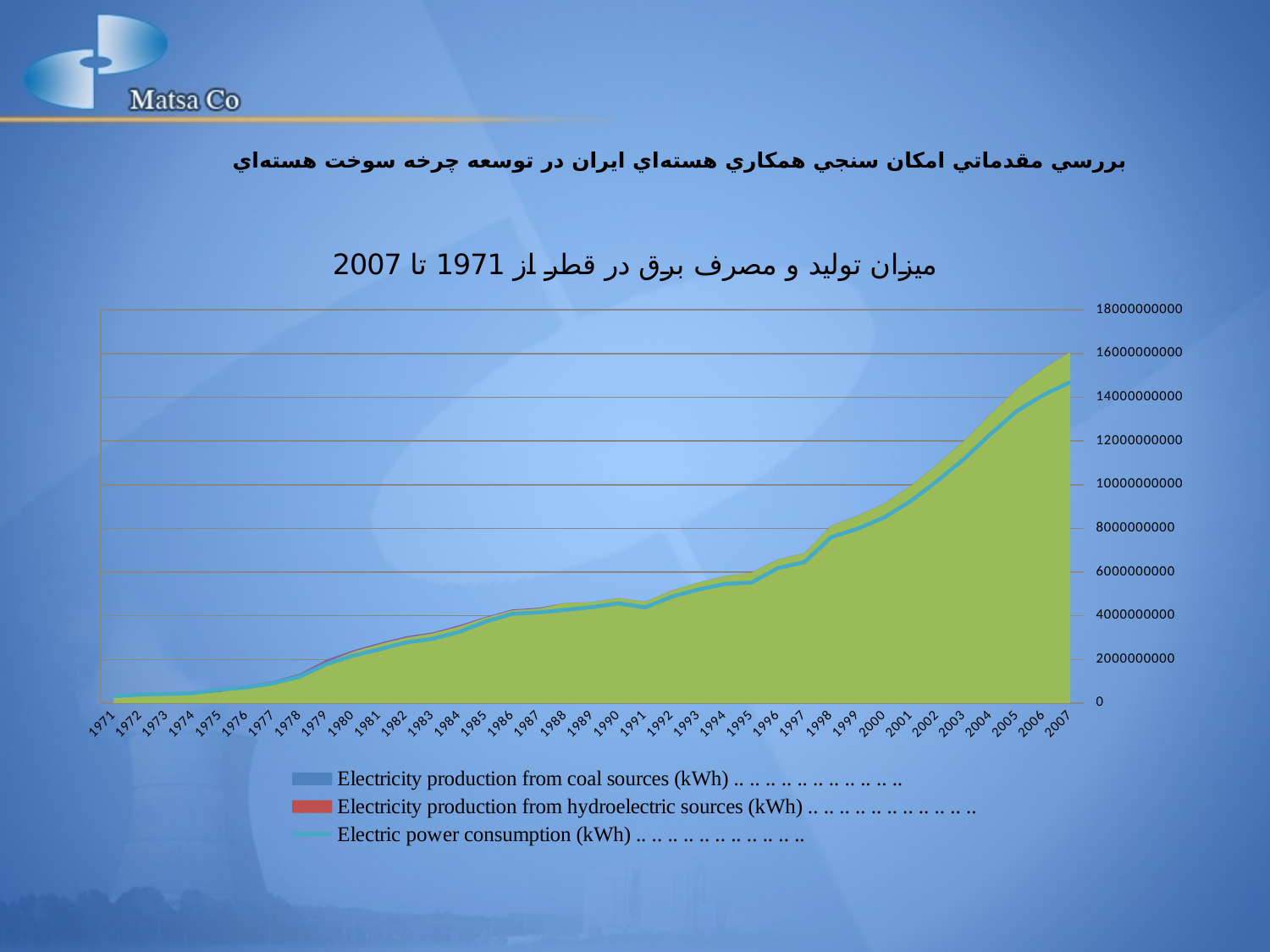
Which year has the larger value for Electric power consumption (kWh), 1995 or 2005? 2005 How many years are plotted along the x axis of the chart? 37 How many series does the chart legend list? 3 What is the first year shown on the x axis of the chart? 1971 What is the last year shown on the x axis of the chart? 2007 In which year is Electric power consumption (kWh) lowest? 1971 What kind of chart is shown on the slide? area and line chart Is the value for Electric power consumption (kWh) in 2007 greater or less than 10000000000? greater Is the value for Electric power consumption (kWh) in 1980 greater or less than 4000000000? less In which year is Electric power consumption (kWh) highest? 2007 Do the plotted values rise or fall from 1971 to 2007? rise Is the value for Electric power consumption (kWh) in 1990 greater or less than 6000000000? less